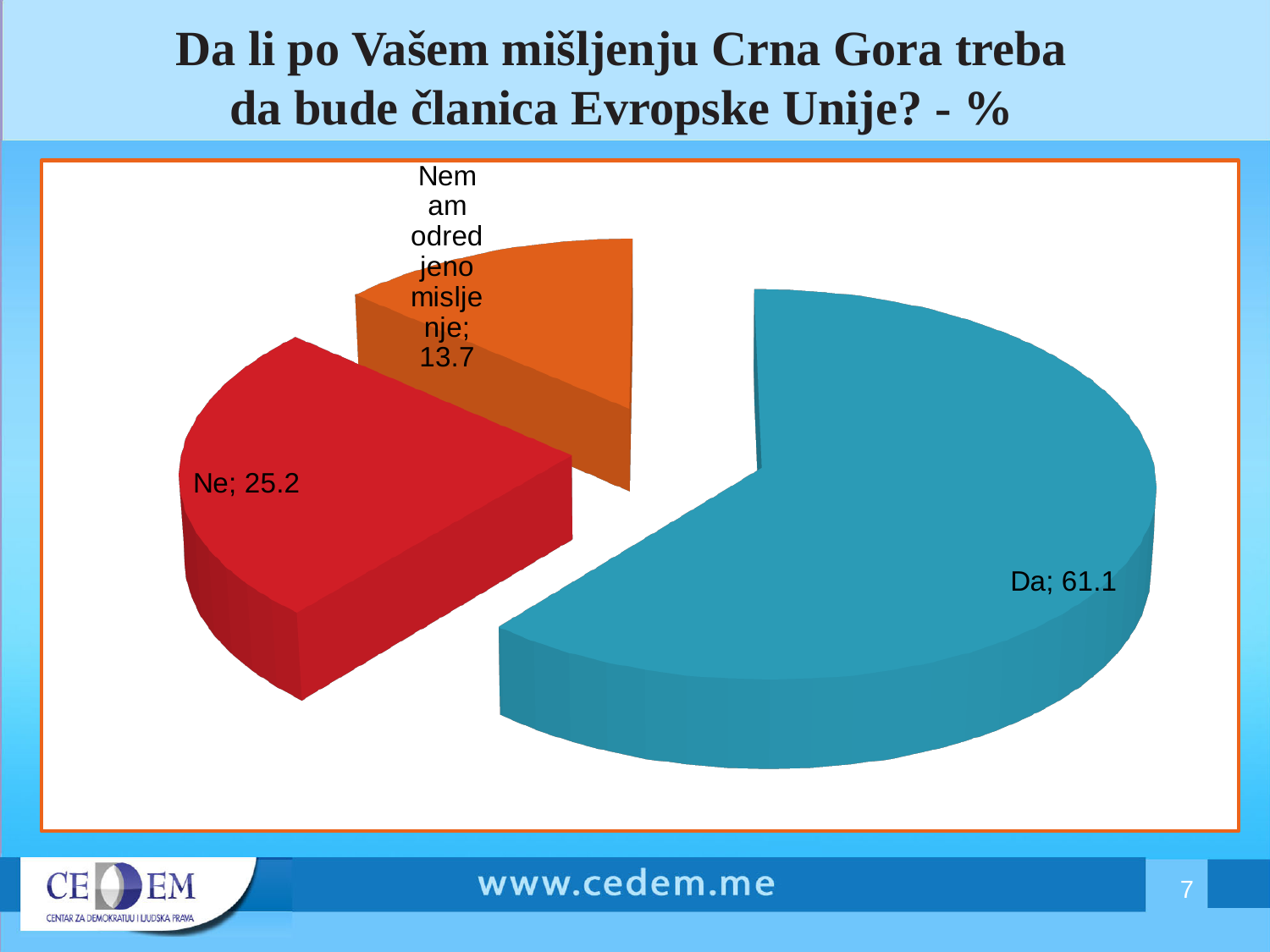
What share of the pie does the "Da" slice represent? 61.1% What colour is the "Ne" slice? Red Which category has the smallest slice of the pie? Nemam određeno mišljenje Which is larger, the value for "Ne" or the value for "Nemam određeno mišljenje"? Ne What value is shown for the "Da" slice? 61.1 What value is shown for the "Ne" slice? 25.2 Which category has the largest slice of the pie? Da What is the difference between the values for "Ne" and "Nemam određeno mišljenje"? 11.5 What kind of chart is shown on the slide? Pie chart How many slices does the pie chart have? 3 What value is shown for the "Nemam određeno mišljenje" slice? 13.7 What is the difference between the values for "Da" and "Ne"? 35.9